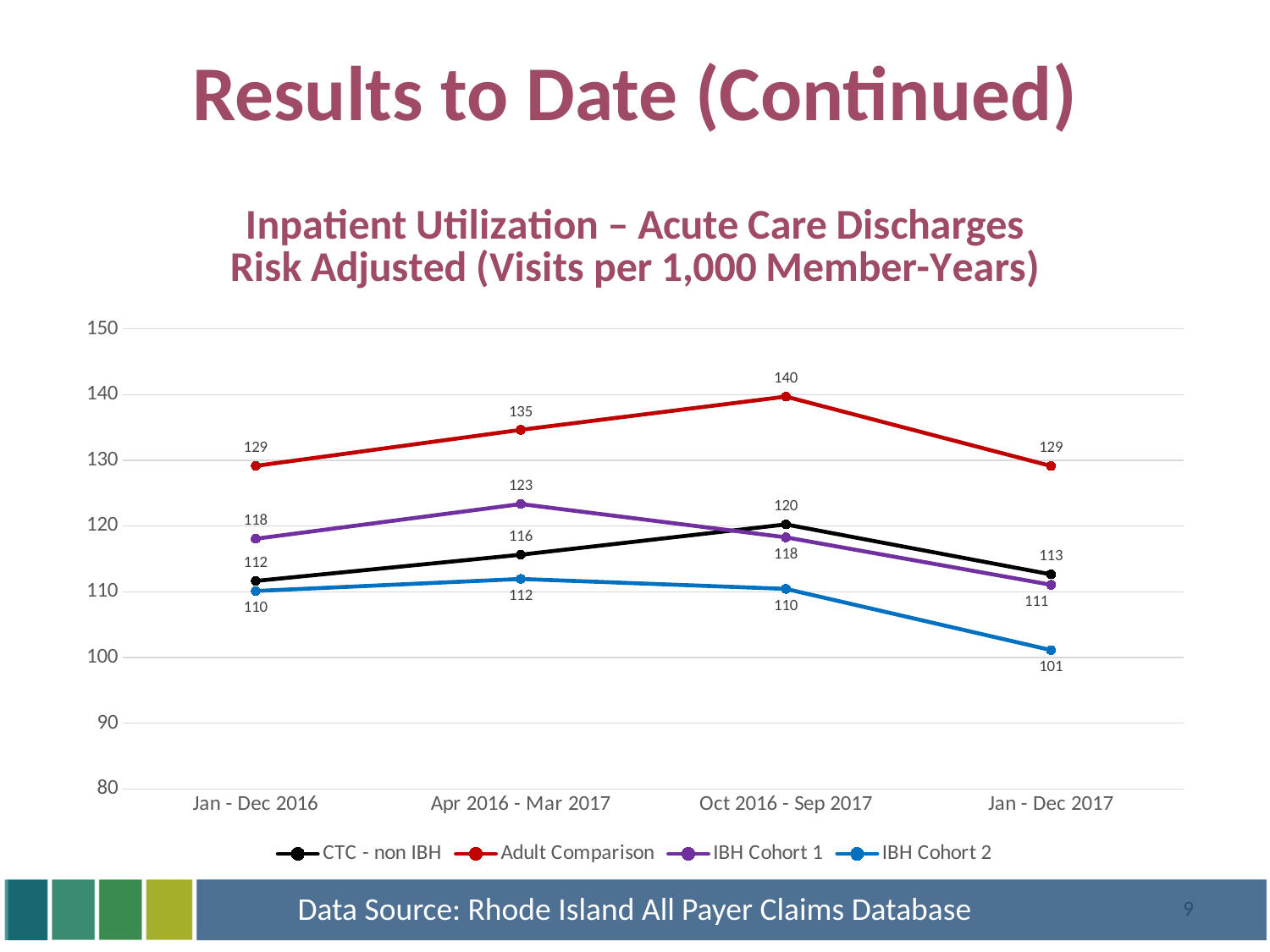
What is the value for Adult Comparison in Oct 2016 - Sep 2017? 140 What kind of chart is shown on the slide? Line chart Does the IBH Cohort 2 series rise or fall from Oct 2016 - Sep 2017 to Jan - Dec 2017? Fall What is the value for CTC - non IBH in Jan - Dec 2016? 112 What is the value for IBH Cohort 2 in Jan - Dec 2017? 101 What is the value for IBH Cohort 1 in Apr 2016 - Mar 2017? 123 How many periods are shown on the x axis? 4 How many series does the legend list? 4 In which period does IBH Cohort 2 have its lowest value? Jan - Dec 2017 In which period does the Adult Comparison series reach its highest value? Oct 2016 - Sep 2017 Which is larger in Apr 2016 - Mar 2017: IBH Cohort 1 or CTC - non IBH? IBH Cohort 1 What is the difference between Adult Comparison and CTC - non IBH in Jan - Dec 2017? 16